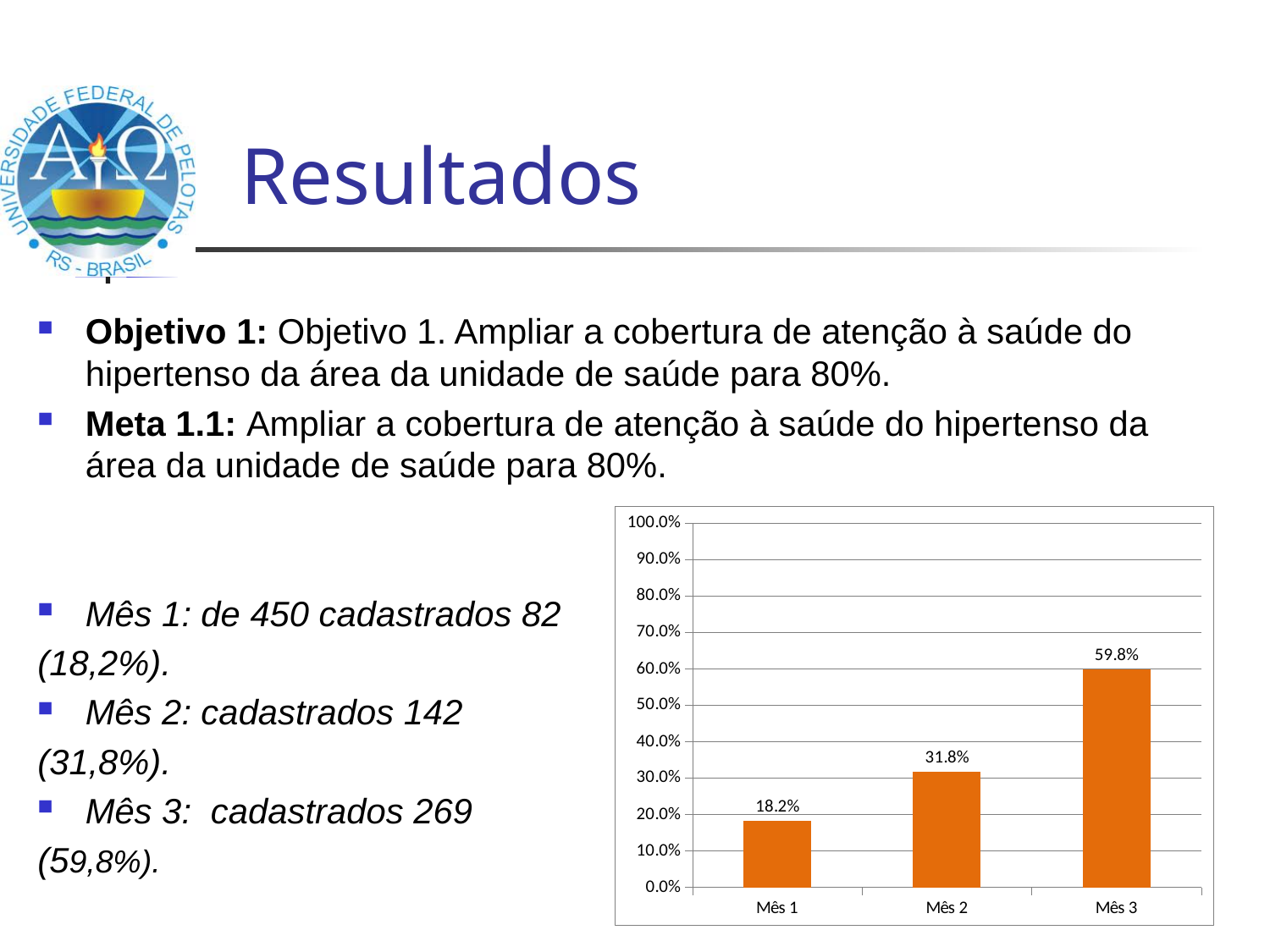
Do the values rise or fall from Mês 1 to Mês 3? rise What is the value for Mês 1? 18.2% What is the value for Mês 3? 59.8% How many categories are shown on the x axis? 3 Which category has the highest value? Mês 3 What is the difference between the values for Mês 3 and Mês 1? 41.6% What kind of chart is shown on the slide? bar chart What is the value for Mês 2? 31.8% Which is larger, the value for Mês 2 or the value for Mês 3? Mês 3 What is the difference between the values for Mês 2 and Mês 1? 13.6% Is the value for Mês 3 greater or less than 50.0%? greater Which category has the lowest value? Mês 1